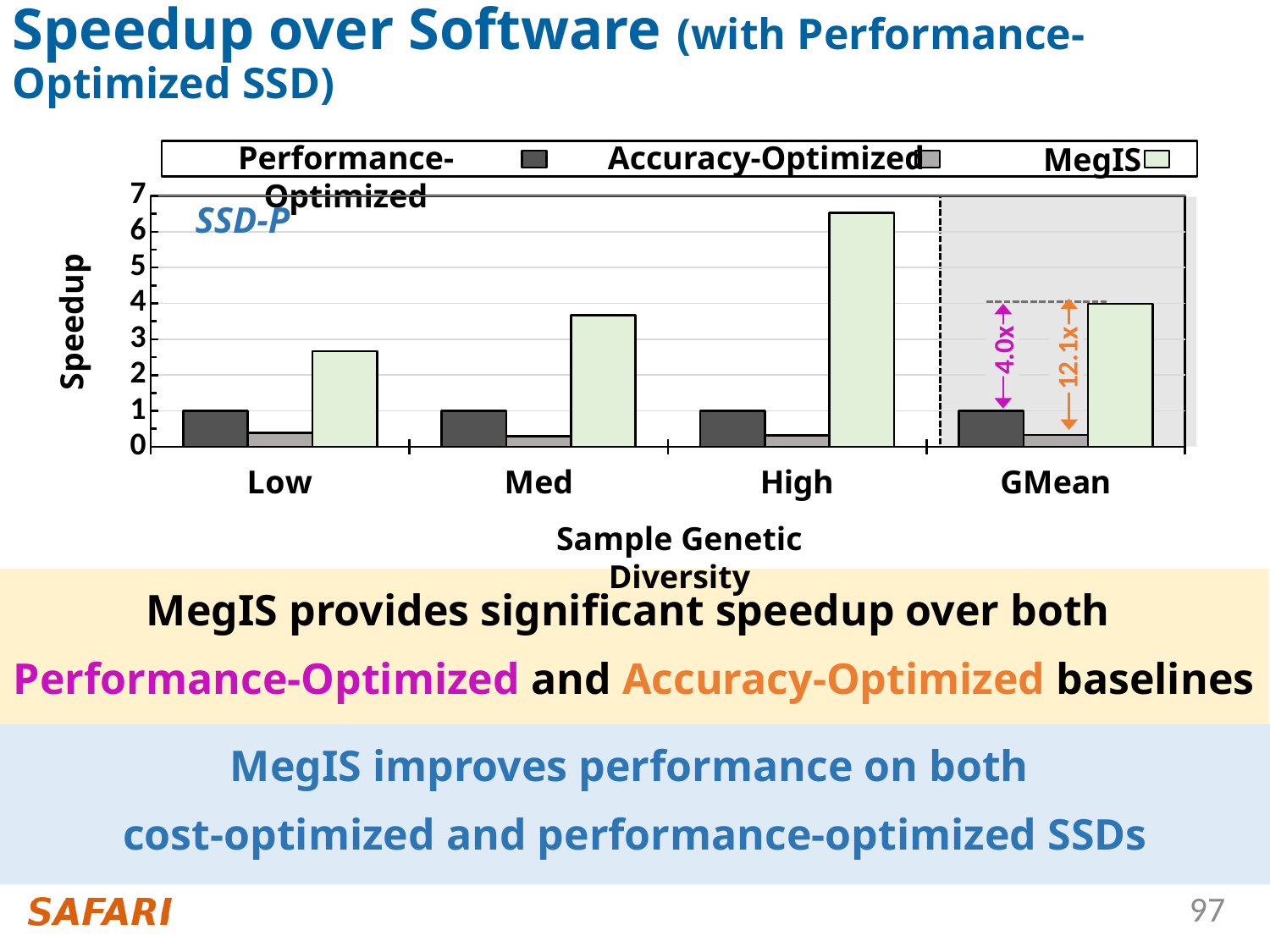
What is the MegIS speedup value for GMean? 4.0x Is the MegIS value for Low greater or less than 3? less What is the Performance-Optimized speedup value for Low? 1 How many series does the legend list? 3 How many categories are shown on the x axis? 4 Which category has the highest MegIS bar? High Which category has the lowest MegIS bar? Low According to the annotation, what is the GMean speedup of MegIS over the Accuracy-Optimized baseline? 12.1x What kind of chart is shown on the slide? bar chart Is the MegIS value for High greater or less than 6? greater At High, which is larger: the MegIS bar or the Accuracy-Optimized bar? MegIS Do the MegIS bars rise or fall from Low to High? rise